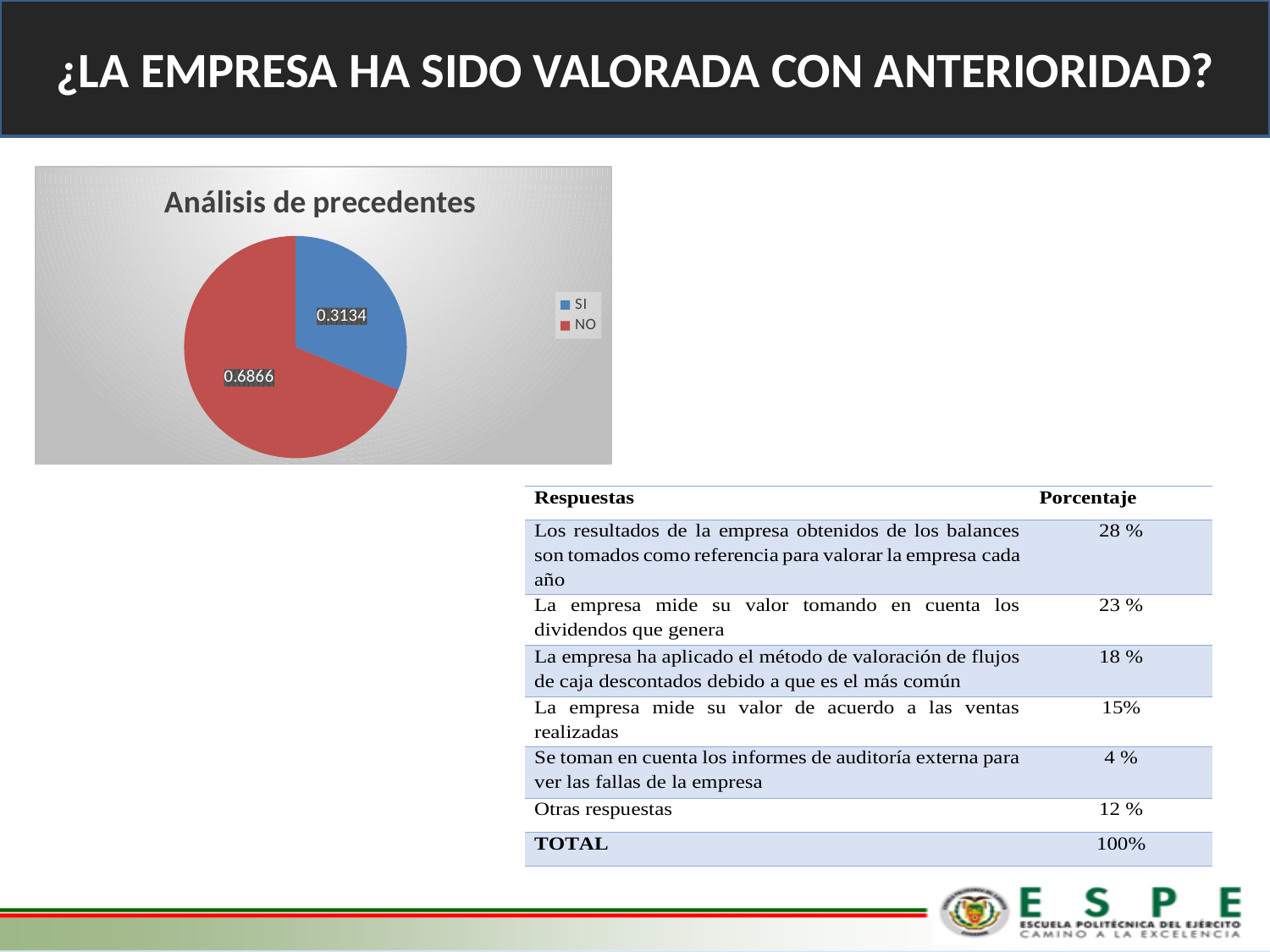
Which category has the largest slice in the pie chart? NO Which category has the smallest slice in the pie chart? SI What is the value shown for NO in the pie chart? 0.6866 What is the title of the pie chart? Análisis de precedentes What colour is the SI slice in the pie chart? blue What is the value shown for SI in the pie chart? 0.3134 Which is larger in the pie chart, SI or NO? NO What is the difference between the values for NO and SI in the pie chart? 0.3732 How many entries does the legend of the pie chart list? 2 How many slices does the pie chart have? 2 What share of the pie does the NO slice represent? 0.6866 What kind of chart is shown on the slide? pie chart